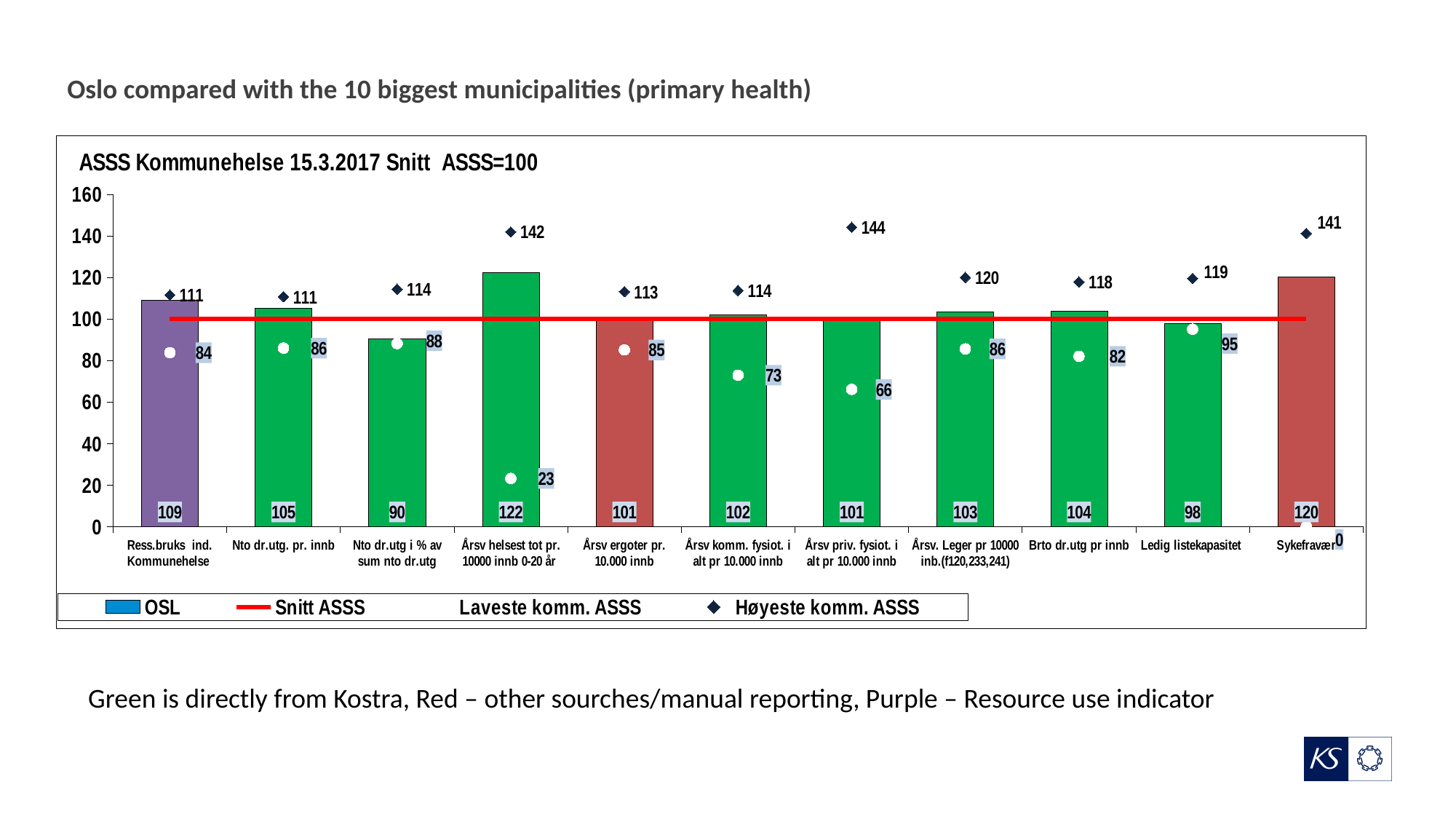
What is the OSL value for Årsv helsest tot pr. 10000 innb 0-20 år? 122 Which is larger, the OSL value for Nto dr.utg. pr. innb or for Brto dr.utg pr innb? Nto dr.utg. pr. innb What is the Laveste komm. ASSS value for Årsv helsest tot pr. 10000 innb 0-20 år? 23 How many categories are shown on the x axis? 11 Is the OSL value for Ledig listekapasitet greater or less than 100? less What is the difference between the Høyeste komm. ASSS value and the OSL value for Årsv helsest tot pr. 10000 innb 0-20 år? 20 What is the title of the chart? ASSS Kommunehelse 15.3.2017 Snitt ASSS=100 What is the Høyeste komm. ASSS value for Årsv priv. fysiot. i alt pr 10.000 innb? 144 How many series does the legend list? 4 Which category has the highest OSL bar? Årsv helsest tot pr. 10000 innb 0-20 år Which category has the lowest Laveste komm. ASSS value? Sykefravær Which category has the lowest OSL bar? Nto dr.utg i % av sum nto dr.utg